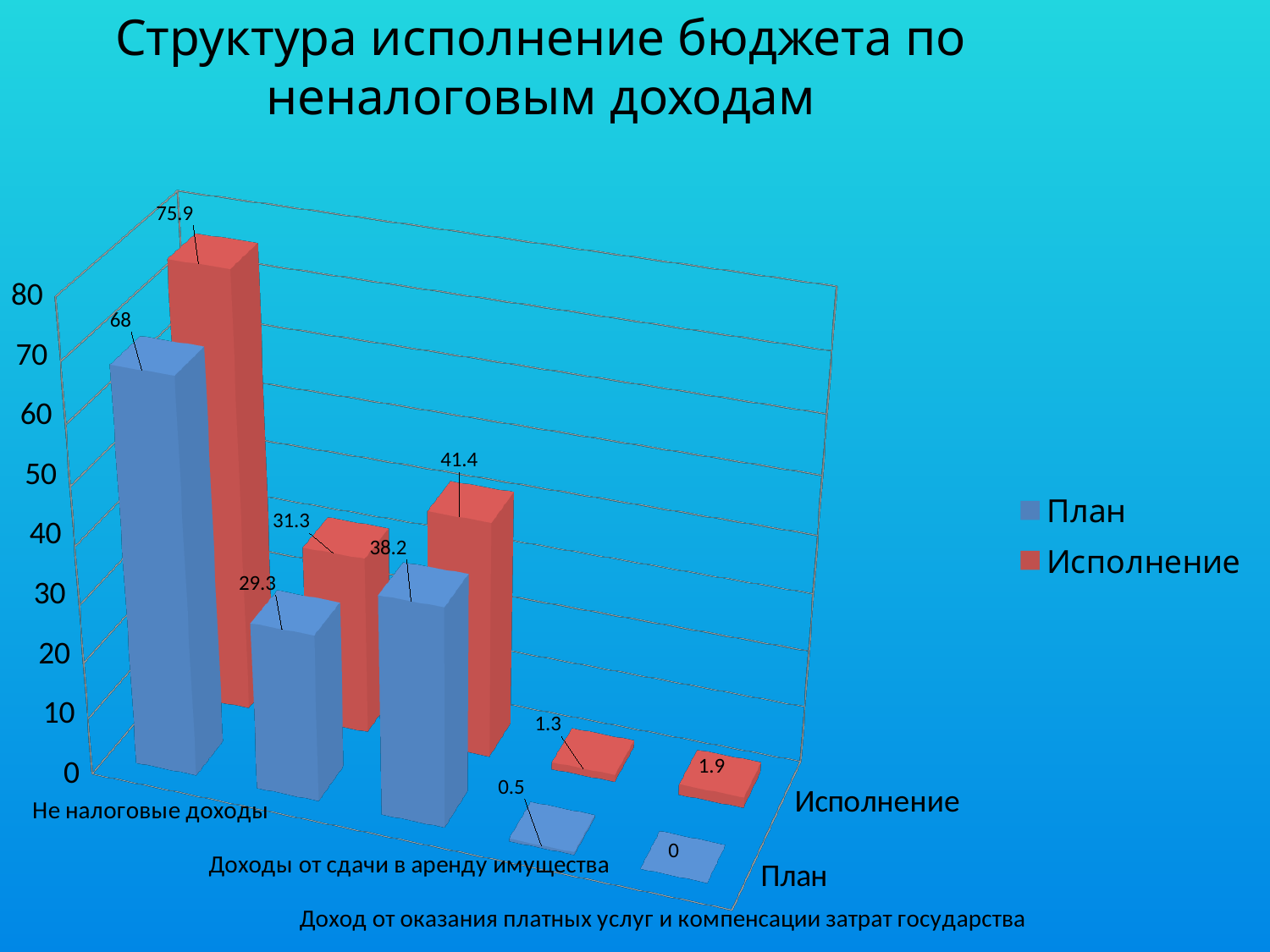
What is the План value for Доходы от сдачи в аренду имущества? 38.2 What is the title of the chart on the slide? Структура исполнение бюджета по неналоговым доходам What kind of chart is shown on the slide? Bar chart What is the difference between the Исполнение and План values for Доход от оказания платных услуг и компенсации затрат государства? 1.9 What is the Исполнение value for Доход от оказания платных услуг и компенсации затрат государства? 1.9 Which of the three labelled categories has the lowest План value? Доход от оказания платных услуг и компенсации затрат государства What is the План value for Не налоговые доходы? 68 Which category has the highest Исполнение value? Не налоговые доходы For Доходы от сдачи в аренду имущества, which is larger: План or Исполнение? Исполнение What is the Исполнение value for Не налоговые доходы? 75.9 How many series does the legend list? 2 What is the difference between the Исполнение and План values for Не налоговые доходы? 7.9